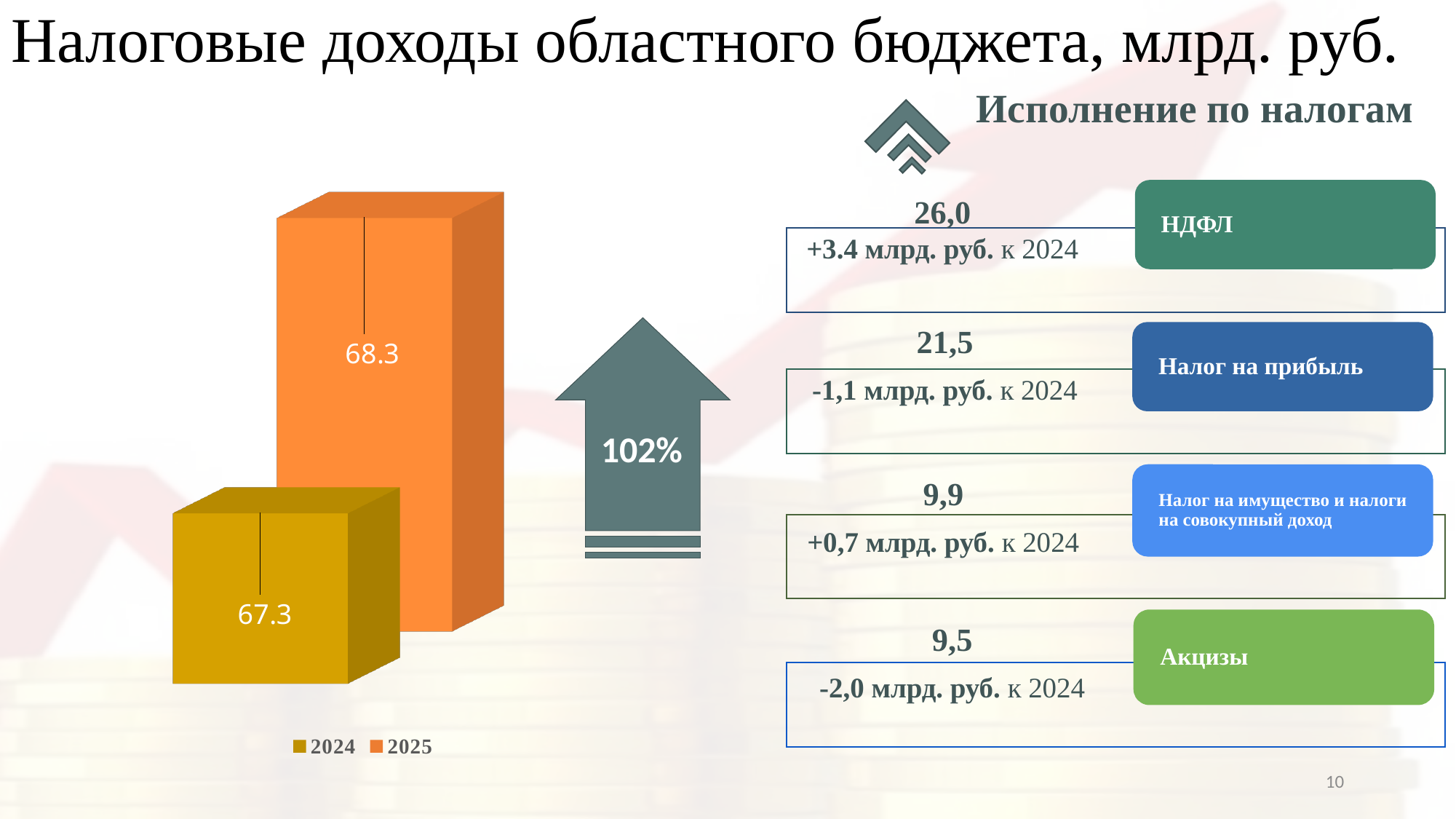
Which bar in the chart is the highest? 2025 What are the two legend entries of the bar chart? 2024 and 2025 What is the difference between the 2025 and 2024 values in the bar chart? 1.0 What colour is the 2025 bar in the chart? Orange What kind of chart is shown on the left of the slide? Bar chart What is the value shown for 2025 in the bar chart? 68.3 What is the value shown for 2024 in the bar chart? 67.3 How many series does the chart legend list? 2 Which bar in the chart is the lowest? 2024 Do the values in the bar chart rise or fall from 2024 to 2025? Rise Which year has the higher value in the bar chart, 2024 or 2025? 2025 How many bars are plotted in the chart? 2